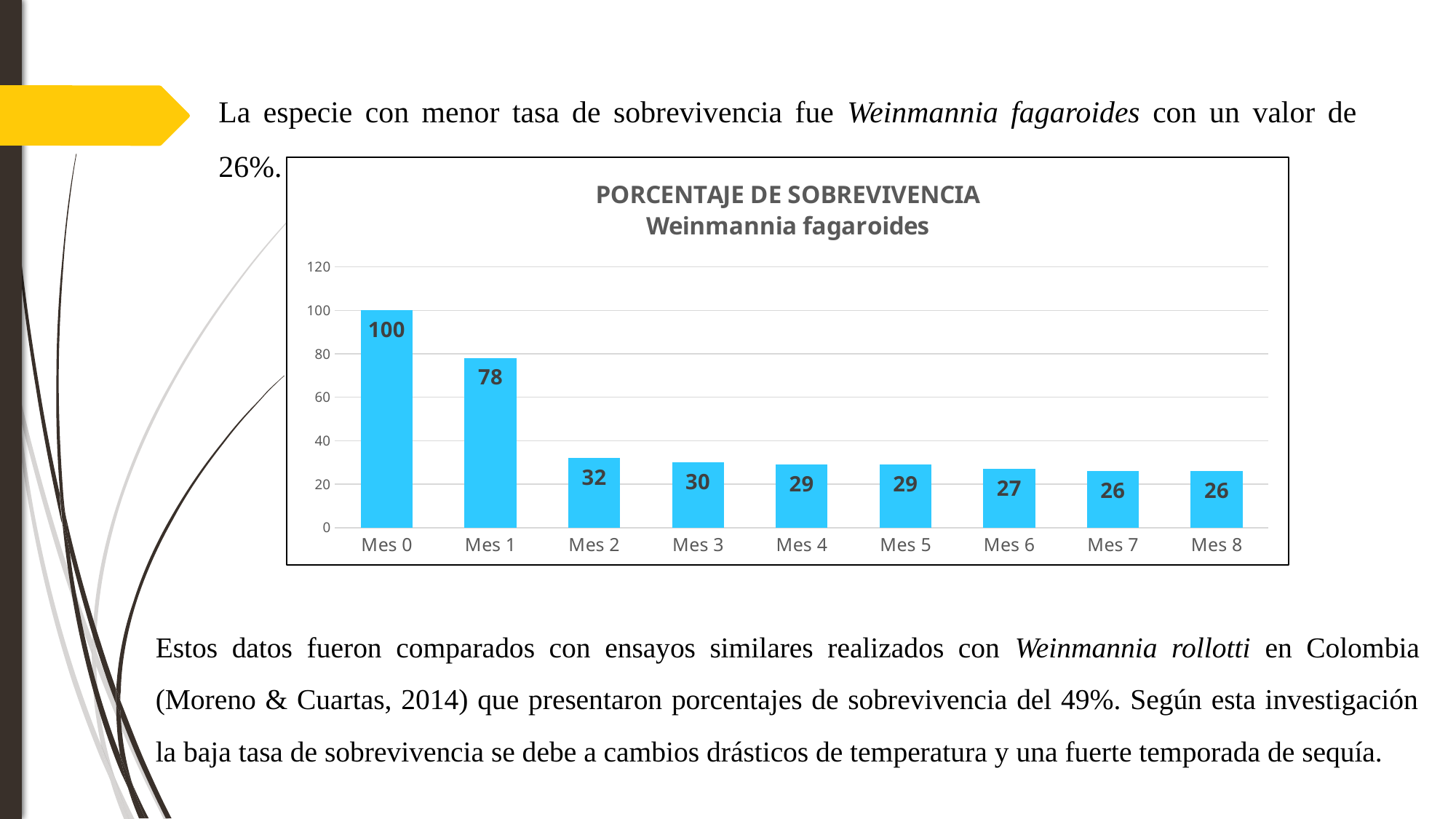
What kind of chart is this? Bar chart Do the values rise or fall from Mes 0 to Mes 8? Fall Which is larger, the value for Mes 2 or the value for Mes 8? Mes 2 What is the value for Mes 1? 78 How many months are shown on the x axis? 9 What is the value for Mes 0? 100 What is the difference between the values for Mes 0 and Mes 1? 22 What is the difference between the values for Mes 1 and Mes 2? 46 What is the value for Mes 2? 32 What is the title of the chart? PORCENTAJE DE SOBREVIVENCIA Weinmannia fagaroides What is the value for Mes 6? 27 Which month has the highest value? Mes 0